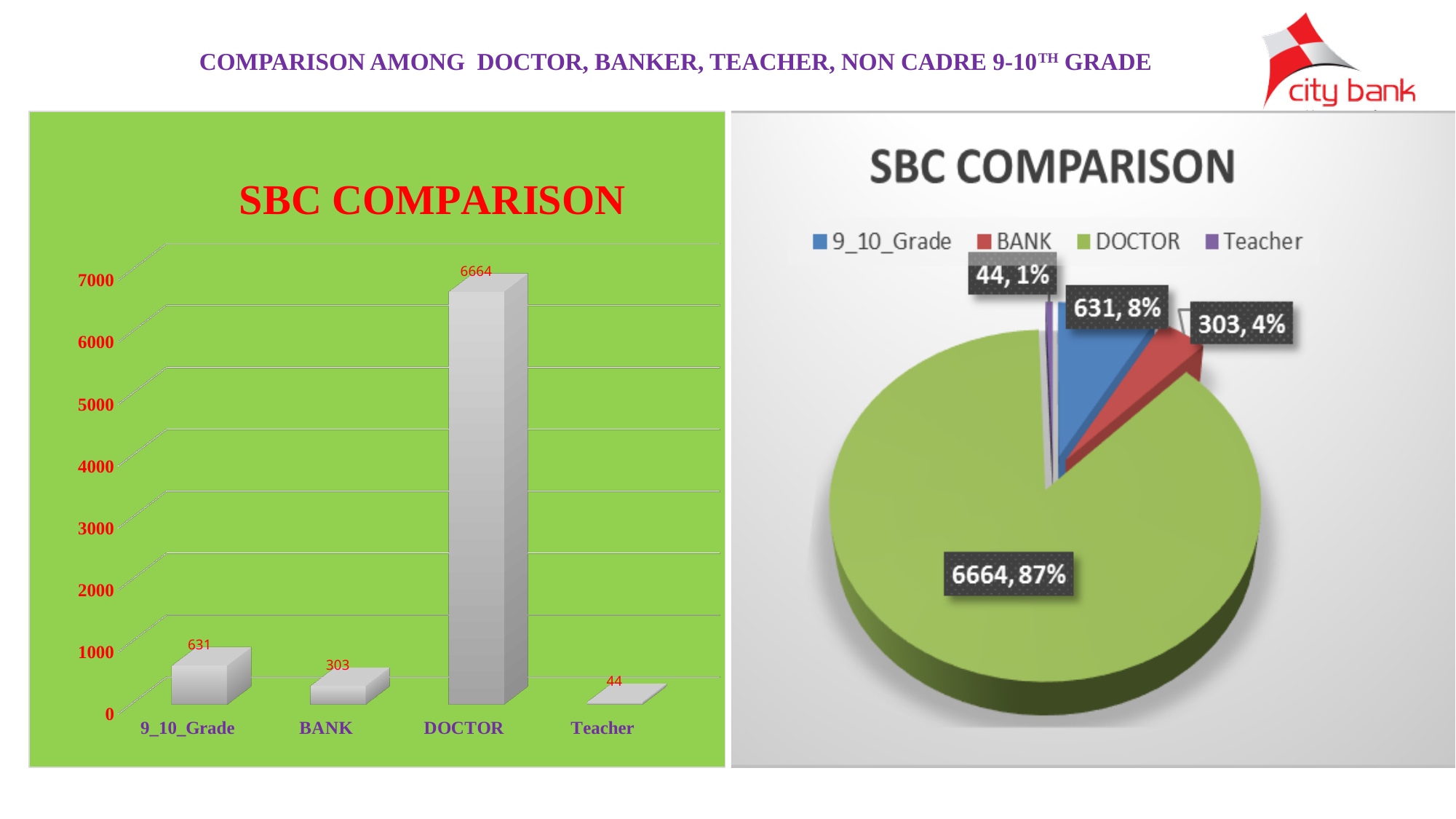
In the bar chart on the left, what is the difference between the values for 9_10_Grade and BANK? 328 In the bar chart on the left, which category has the lowest value? Teacher In the bar chart on the left, which is larger, the value for BANK or the value for Teacher? BANK In the bar chart on the left, what is the value for DOCTOR? 6664 In the bar chart on the left, what is the value for 9_10_Grade? 631 In the bar chart on the left, what is the value for Teacher? 44 How many entries does the legend of the pie chart on the right list? 4 In the bar chart on the left, which category has the highest value? DOCTOR What kind of chart is the chart on the left of the slide? bar chart How many categories are shown in the bar chart on the left? 4 In the pie chart on the right, what share of the pie does DOCTOR have? 87% In the pie chart on the right, what share of the pie does BANK have? 4%